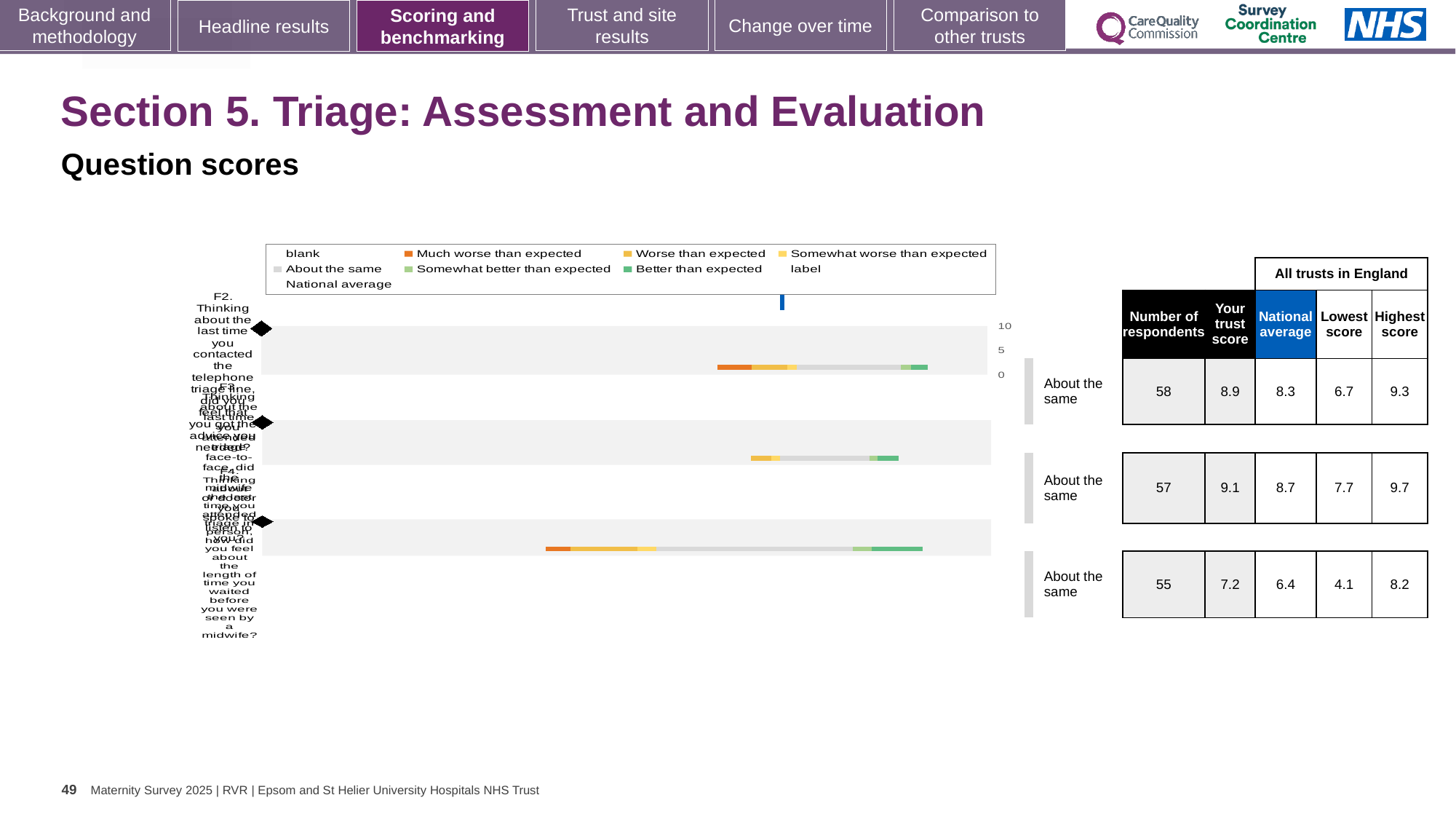
In the table to the right of the chart, how many respondents are listed for the third row? 55 How many question rows (bars) does the chart show? 3 In the table to the right of the chart, which row has the highest 'Your trust score'? the second row (9.1) What benchmark category is shown next to each of the three rows? About the same In the chart legend, which colour represents 'Much worse than expected'? orange In the table to the right of the chart, what is the lowest score for the third row? 4.1 In the table to the right of the chart, is the trust score in the first row larger or smaller than the national average? larger In the table to the right of the chart, what is the difference between the trust score and the national average in the third row? 0.8 What kind of chart is shown on the slide? bar chart In the chart legend, which colour represents 'Better than expected'? green In the table to the right of the chart, what is the national average for the second row? 8.7 In the table to the right of the chart, what is the 'Your trust score' for the first row? 8.9